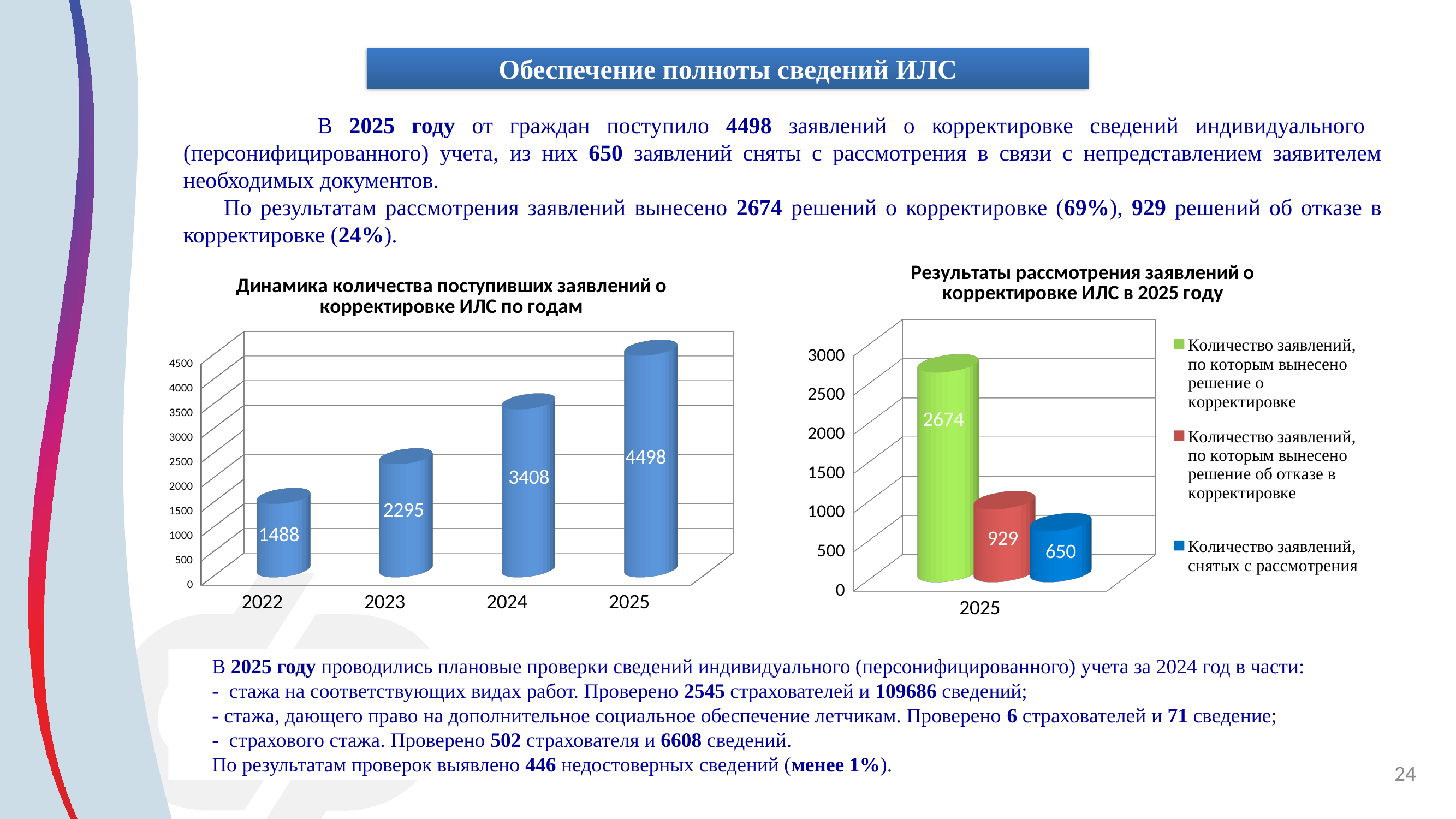
In the chart 'Результаты рассмотрения заявлений о корректировке ИЛС в 2025 году', which is larger: the value for decisions refusing correction (929) or the value for applications withdrawn from consideration (650)? 929 In the chart 'Динамика количества поступивших заявлений о корректировке ИЛС по годам', what is the difference between the values for 2025 and 2024? 1090 In the chart 'Результаты рассмотрения заявлений о корректировке ИЛС в 2025 году', which series has the highest value? Количество заявлений, по которым вынесено решение о корректировке In the chart 'Динамика количества поступивших заявлений о корректировке ИЛС по годам', do the values rise or fall from 2022 to 2025? rise What kind of chart is 'Динамика количества поступивших заявлений о корректировке ИЛС по годам'? bar chart In the chart 'Результаты рассмотрения заявлений о корректировке ИЛС в 2025 году', what is the value for 'Количество заявлений, снятых с рассмотрения'? 650 In the chart 'Динамика количества поступивших заявлений о корректировке ИЛС по годам', how many years are shown? 4 In the chart 'Динамика количества поступивших заявлений о корректировке ИЛС по годам', which year has the lowest value? 2022 In the chart 'Результаты рассмотрения заявлений о корректировке ИЛС в 2025 году', what is the difference between the values 2674 and 929? 1745 In the chart 'Динамика количества поступивших заявлений о корректировке ИЛС по годам', which year has the highest value? 2025 In the chart 'Динамика количества поступивших заявлений о корректировке ИЛС по годам', what is the value for 2023? 2295 In the chart 'Результаты рассмотрения заявлений о корректировке ИЛС в 2025 году', how many series does the legend list? 3